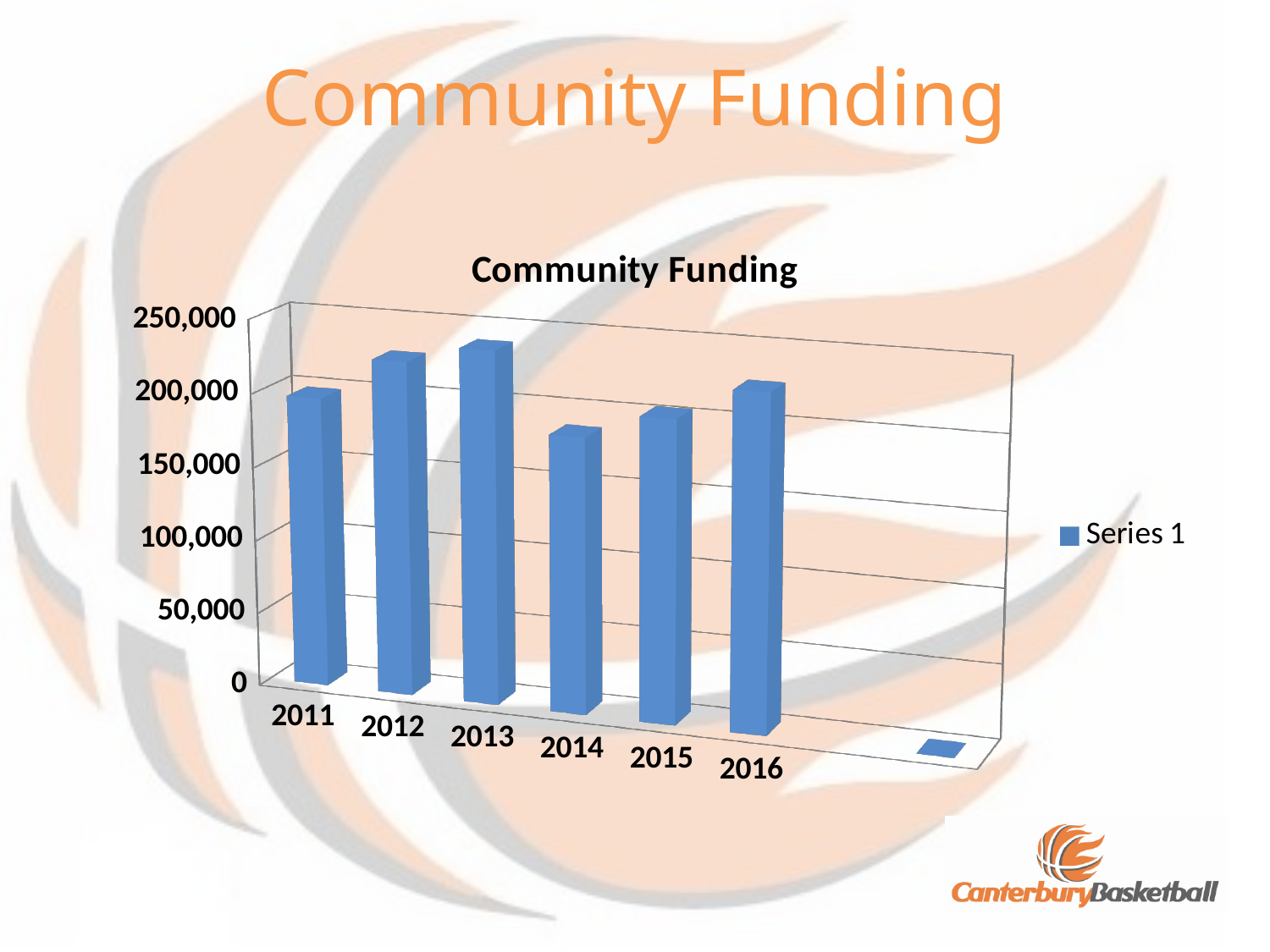
Is the value for 2014 greater or less than 200,000? less How many series does the legend list? 1 What kind of chart is shown on the slide? bar chart Which year has the lowest community funding? 2014 Do the values rise or fall from 2014 to 2016? rise Which year has the highest community funding? 2013 Is the value for 2014 greater or less than 150,000? greater What is the title of the chart? Community Funding How many years are shown on the x axis of the chart? 6 Which is larger, the value for 2012 or the value for 2015? 2012 Is the value for 2013 greater or less than 200,000? greater